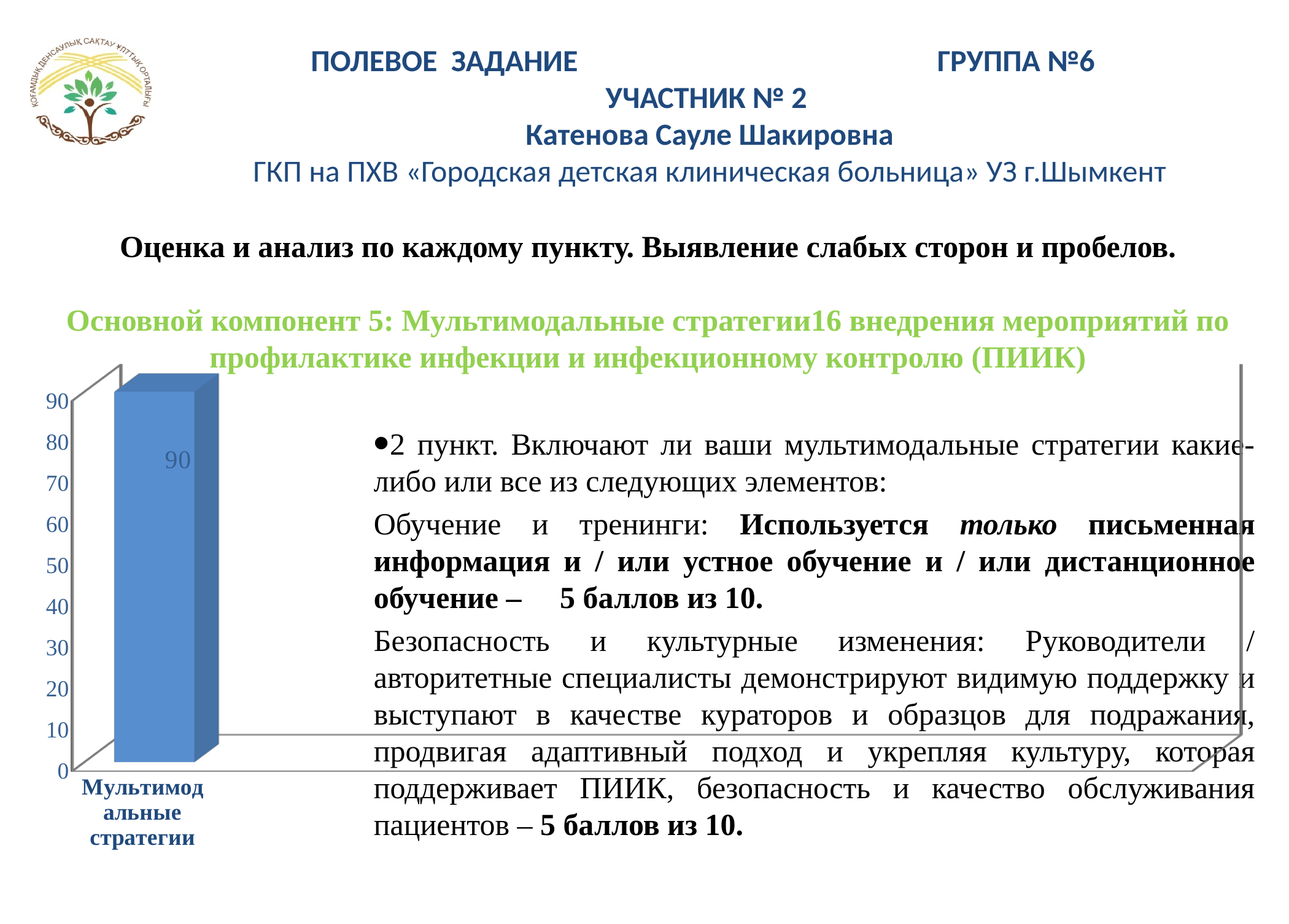
What kind of chart is shown on the slide? bar chart What is the highest tick value shown on the vertical axis of the chart? 90 What is the lowest tick value shown on the vertical axis of the chart? 0 How many bars does the chart contain? 1 Is the value for Мультимодальные стратегии greater or less than 80? greater Is the value for Мультимодальные стратегии greater or less than 50? greater What is the value shown for Мультимодальные стратегии in the chart? 90 What is the category label under the bar in the chart? Мультимодальные стратегии